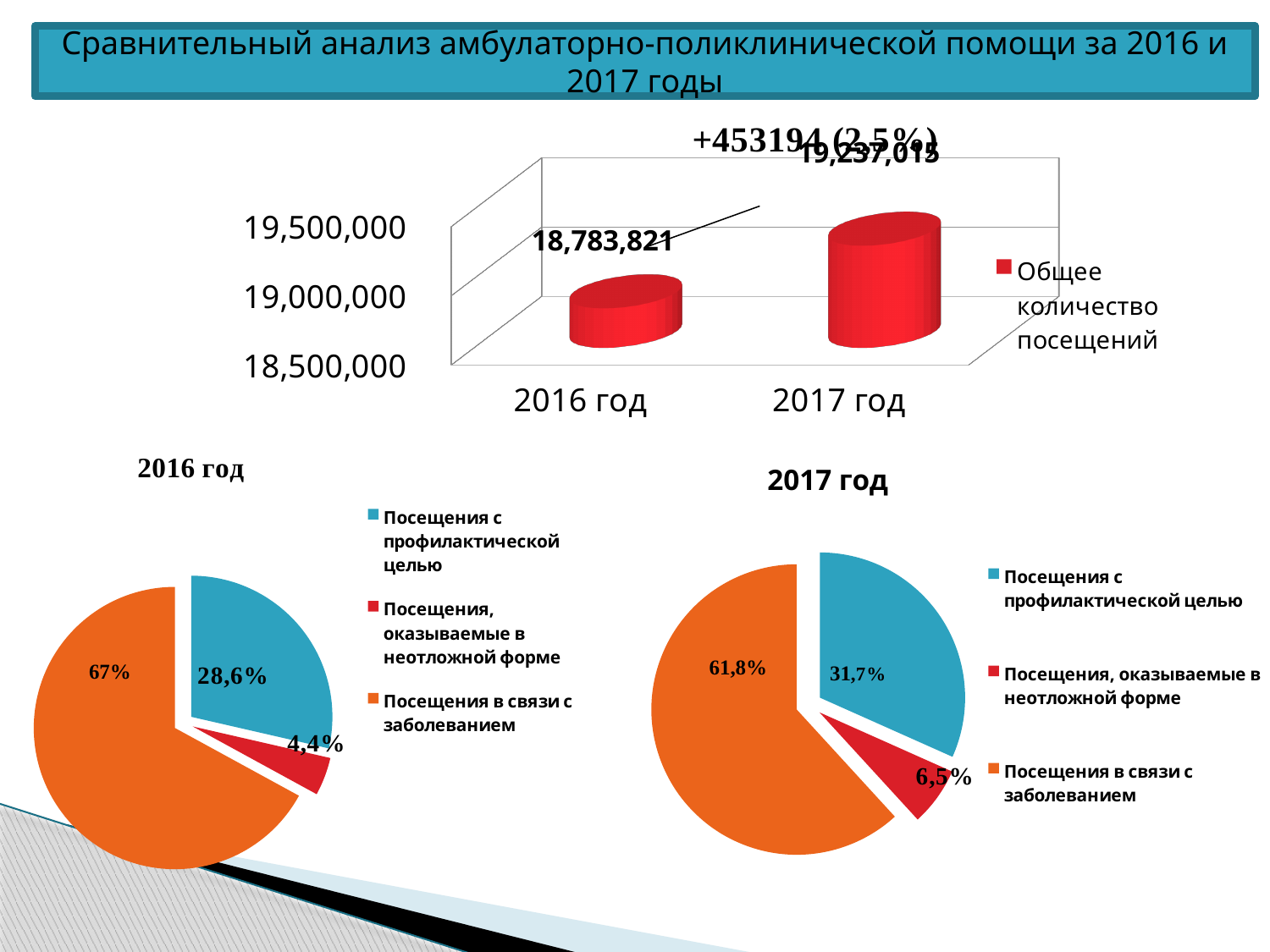
In the 2016 год pie chart, which category has the largest slice? Посещения в связи с заболеванием How many categories are shown on the x axis of the top bar chart? 2 In the top bar chart, what is the total number of visits for 2016 год? 18,783,821 In the 2017 год pie chart, what share is Посещения в связи с заболеванием? 61,8% In the 2016 год pie chart, what share is Посещения, оказываемые в неотложной форме? 4,4% How many series does the legend of the top bar chart list? 1 In the top bar chart, which year has the higher total number of visits, 2016 год or 2017 год? 2017 год What is the difference between the share of Посещения с профилактической целью in the 2017 год pie chart and in the 2016 год pie chart? 3,1% In the 2016 год pie chart, what share is Посещения с профилактической целью? 28,6% In the top bar chart, is the value for 2016 год greater or less than 19,000,000? less What kind of chart is the top chart on the slide? bar chart In the 2017 год pie chart, which category has the smallest slice? Посещения, оказываемые в неотложной форме